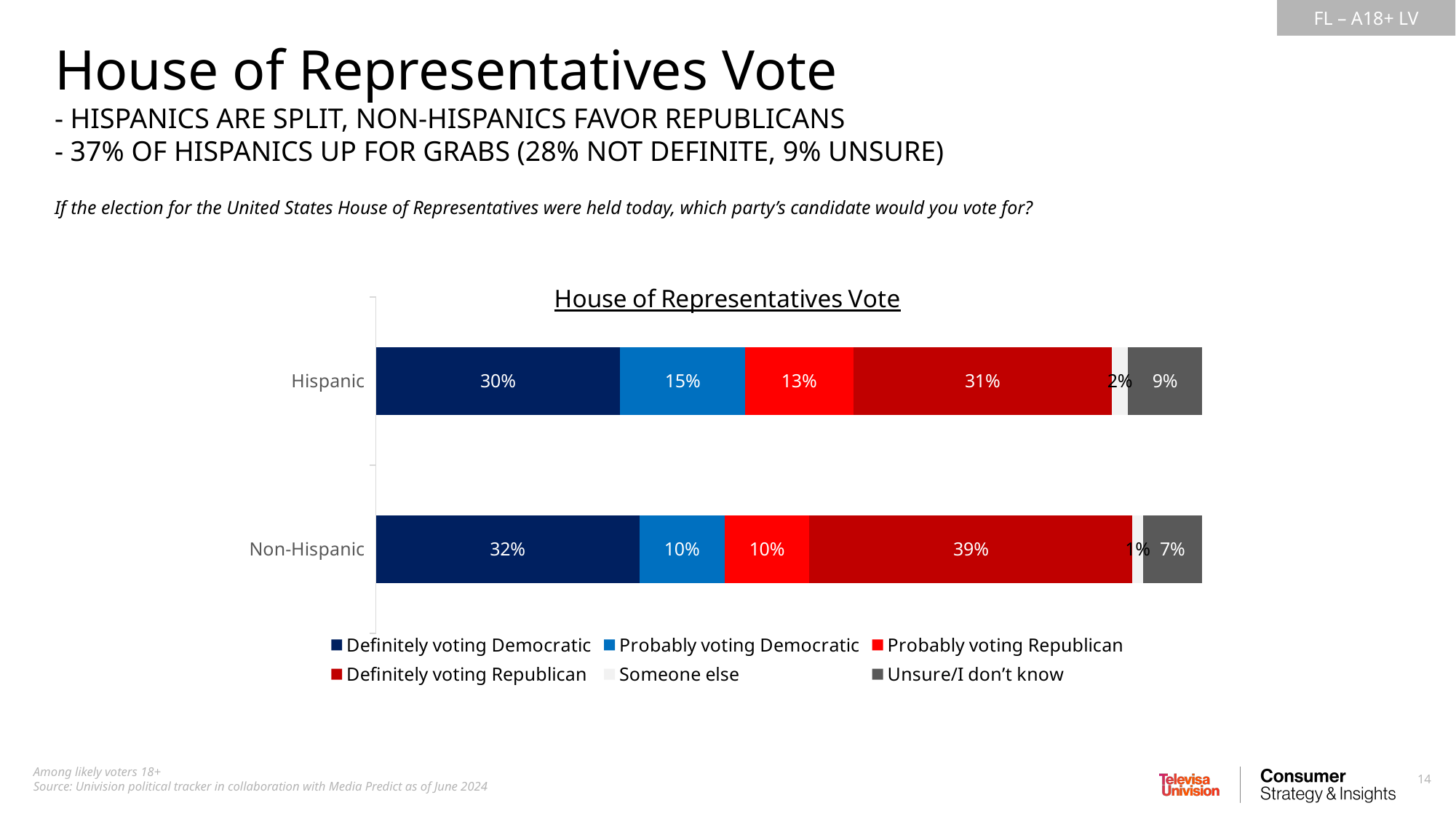
What is the difference between the Non-Hispanic and Hispanic shares definitely voting Republican? 8% What percentage of Hispanic respondents are unsure/don't know? 9% How many series does the legend list? 6 What percentage of Non-Hispanic likely voters are definitely voting Republican? 39% What is the difference between the Hispanic and Non-Hispanic shares probably voting Democratic? 5% What type of chart is shown on the slide? Stacked bar chart Which group has the higher share definitely voting Republican, Hispanic or Non-Hispanic? Non-Hispanic Which response category is the smallest for the Non-Hispanic bar? Someone else What percentage of Hispanic likely voters are definitely voting Democratic? 30% How many groups (bars) are shown in the chart? 2 What percentage of Non-Hispanic respondents are probably voting Democratic? 10% Which response category is the largest for the Hispanic bar? Definitely voting Republican